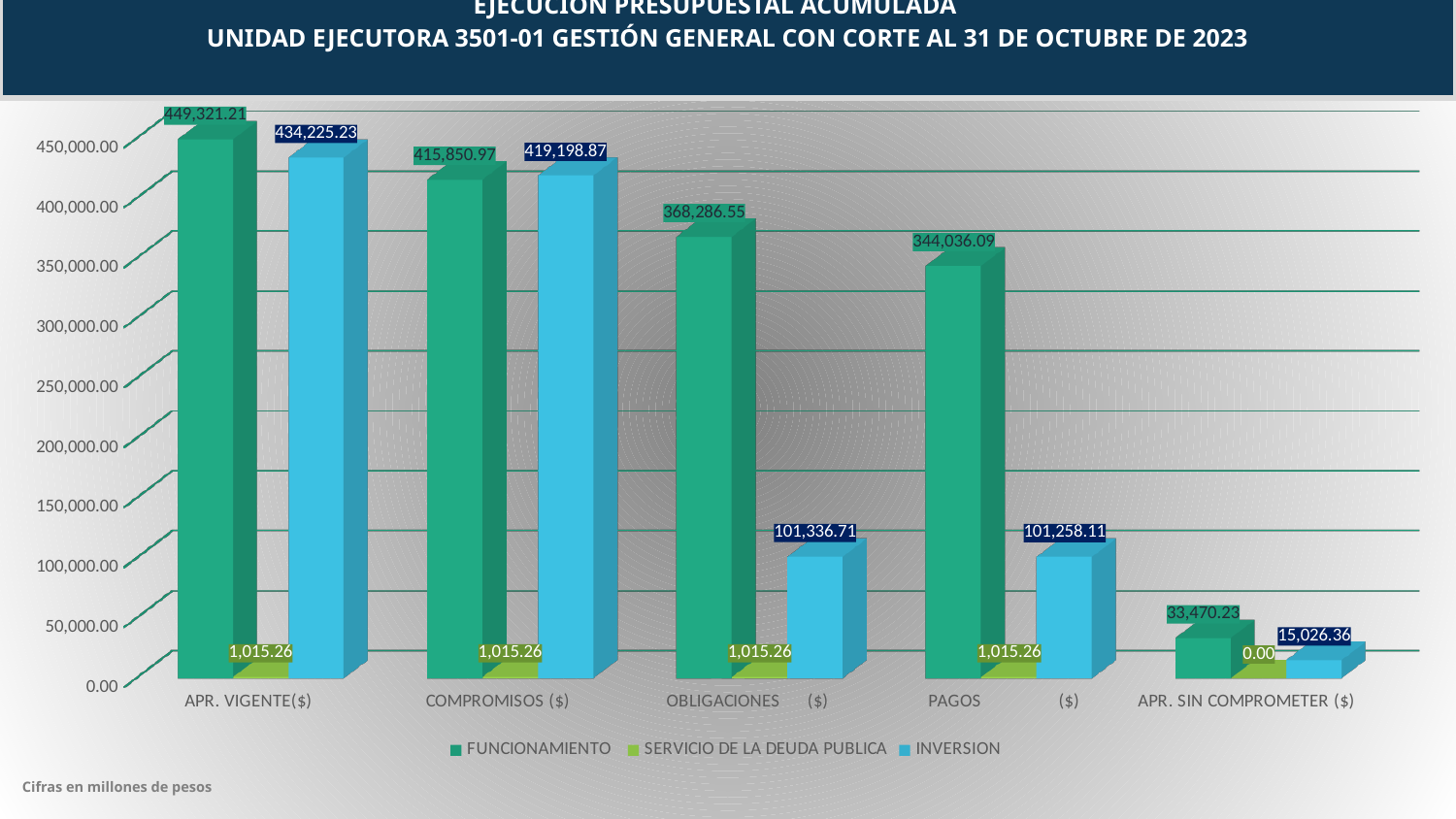
What kind of chart is shown on the slide? Bar chart What is the SERVICIO DE LA DEUDA PUBLICA value for APR. SIN COMPROMETER ($)? 0.00 What is the FUNCIONAMIENTO value for APR. VIGENTE($)? 449,321.21 What is the INVERSION value for COMPROMISOS ($)? 419,198.87 For COMPROMISOS ($), which is larger: FUNCIONAMIENTO or INVERSION? INVERSION How many categories are shown on the x axis? 5 Which category has the lowest INVERSION value? APR. SIN COMPROMETER ($) What is the difference between the FUNCIONAMIENTO and INVERSION values for APR. VIGENTE($)? 15,095.98 Which category has the highest FUNCIONAMIENTO value? APR. VIGENTE($) How many series does the legend list? 3 What is the INVERSION value for PAGOS ($)? 101,258.11 What is the difference between the FUNCIONAMIENTO values for OBLIGACIONES ($) and PAGOS ($)? 24,250.46